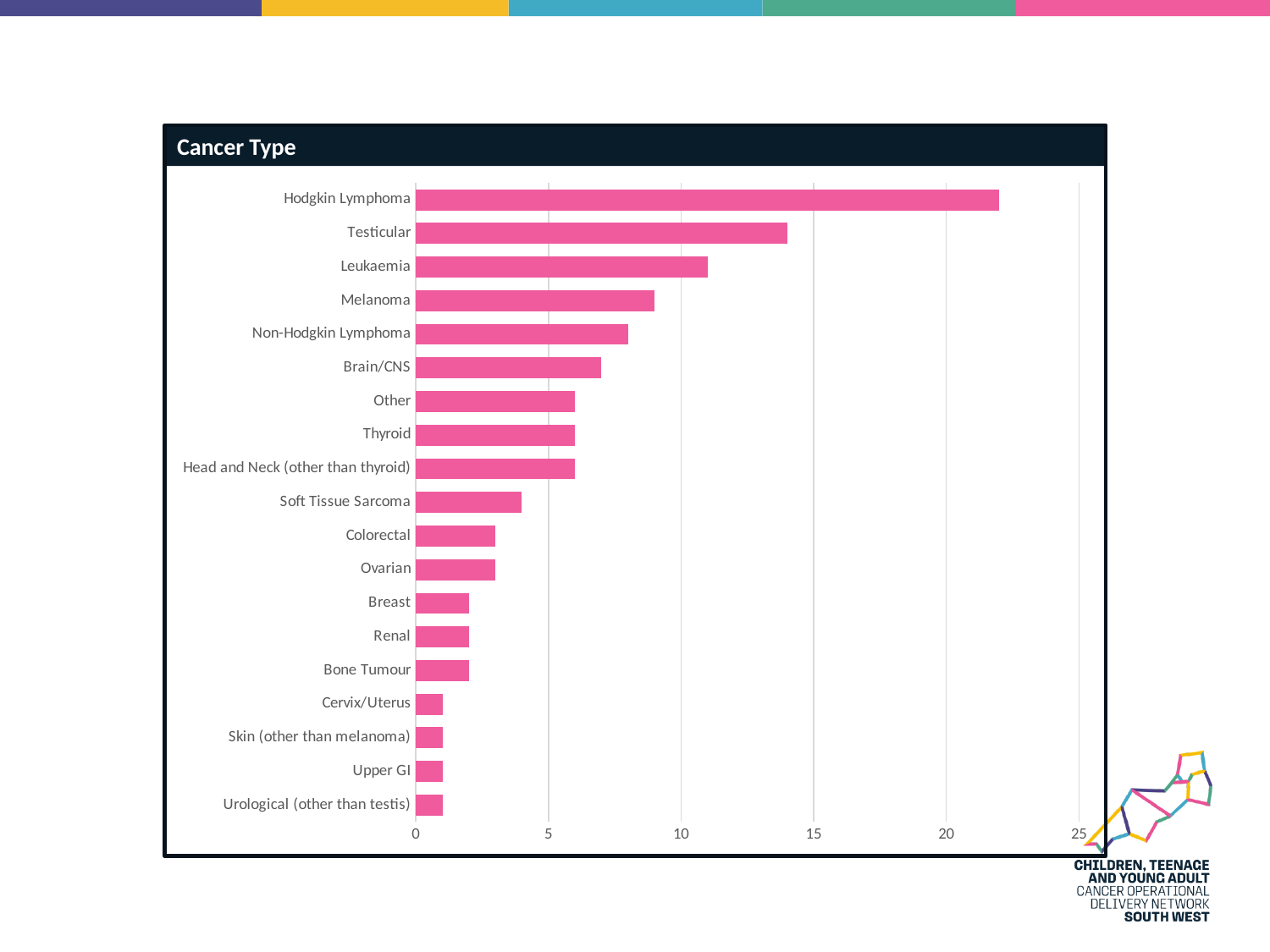
Is the value for Leukaemia greater or less than 10? greater Which cancer type has the highest value in the chart? Hodgkin Lymphoma What is the title of the chart? Cancer Type What is the highest value shown on the horizontal axis? 25 Is the value for Melanoma greater or less than 10? less How many cancer types are plotted in the chart? 19 Is the value for Testicular greater or less than 15? less What kind of chart is shown on the slide? bar chart Which has a larger value, Testicular or Leukaemia? Testicular Which has a larger value, Brain/CNS or Colorectal? Brain/CNS